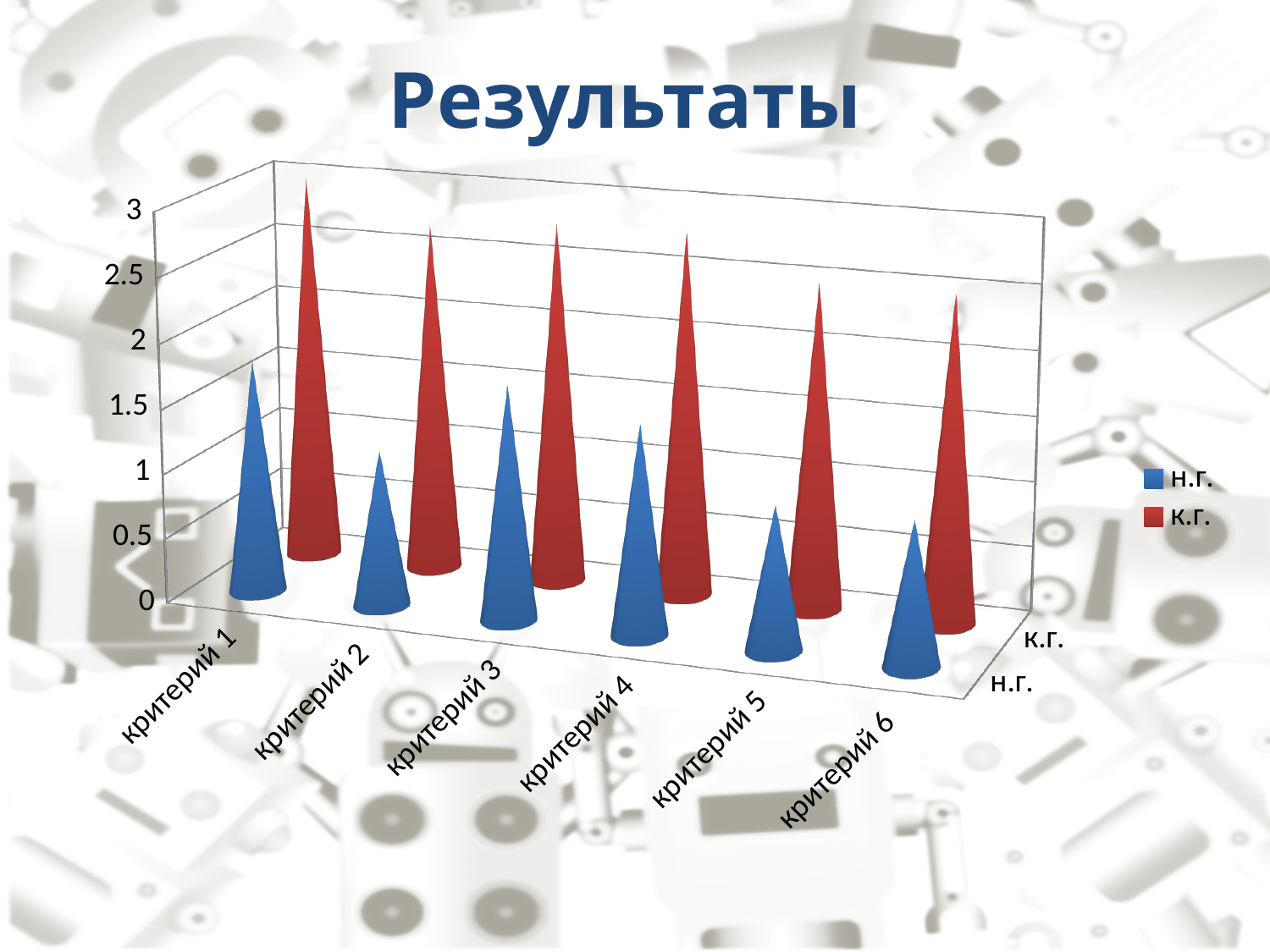
What is the title of the chart? Результаты For критерий 1, which series has the larger value, н.г. or к.г.? к.г. Is the н.г. value for критерий 1 greater or less than 2.5? less For критерий 4, which series has the larger value, н.г. or к.г.? к.г. What kind of chart is shown on the slide? bar chart Is the н.г. value for критерий 5 greater or less than 2? less Is the к.г. value for критерий 4 greater or less than 1.5? greater For критерий 6, which series has the larger value, н.г. or к.г.? к.г. Which series is shown in red? к.г. How many series does the legend list? 2 How many categories (criteria) are shown on the x axis? 6